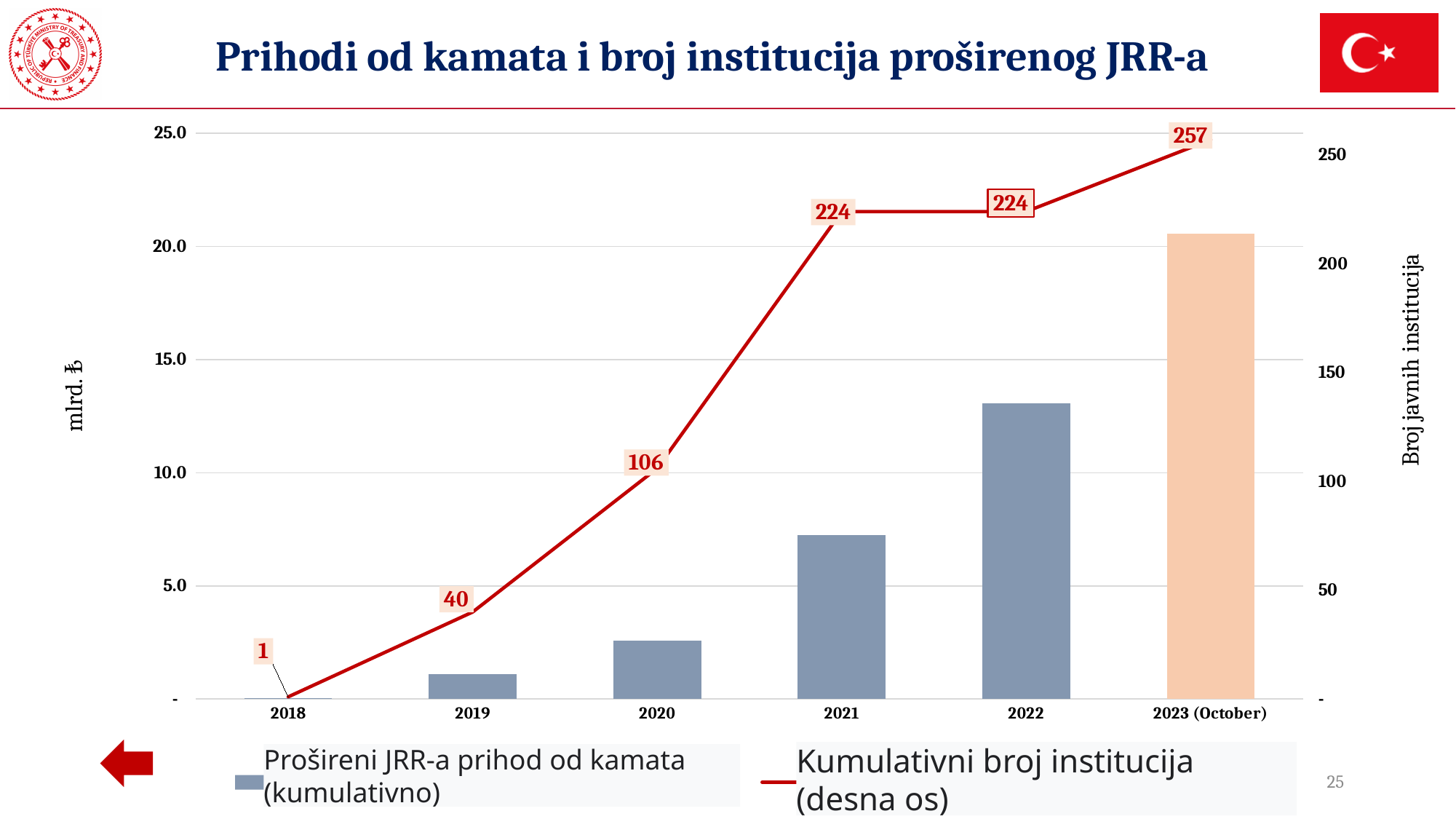
Is the cumulative interest income bar for 2023 (October) greater or less than 20.0 mlrd ₺? greater What is the cumulative number of institutions shown for 2020? 106 Which year has the highest cumulative number of institutions on the line? 2023 (October) How many series does the legend list? 2 By how much did the cumulative number of institutions increase from 2022 to 2023 (October)? 33 By how much did the cumulative number of institutions increase from 2019 to 2020? 66 What is the cumulative number of institutions shown for 2019? 40 Is the cumulative interest income bar for 2022 greater or less than 10.0 mlrd ₺? greater What is the cumulative number of institutions shown for 2023 (October)? 257 Which year has the lowest cumulative number of institutions on the line? 2018 How many years are shown on the x axis of the chart? 6 Is the cumulative interest income bar for 2021 greater or less than 10.0 mlrd ₺? less